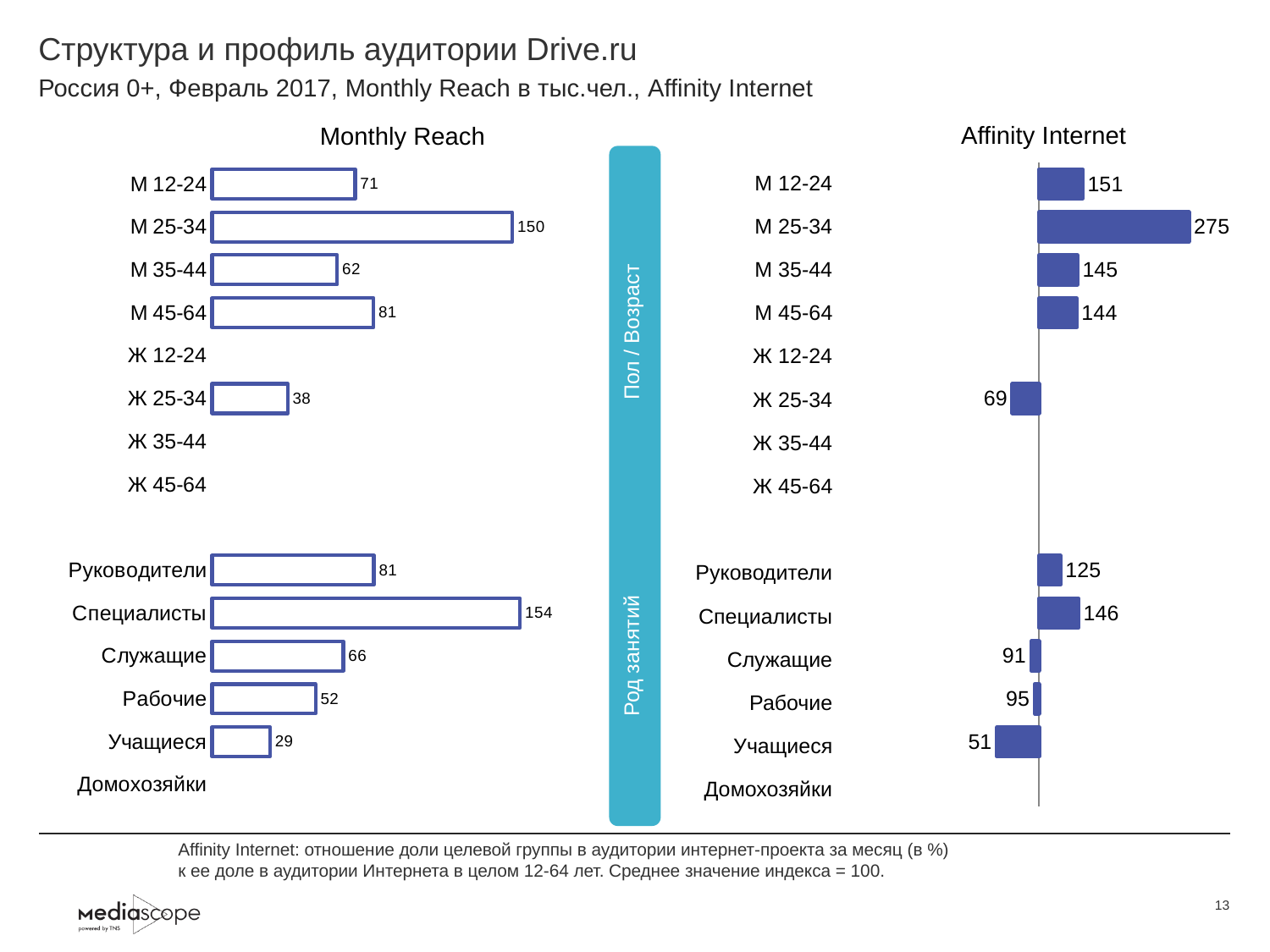
In the Monthly Reach chart, what is the value for М 25-34? 150 In the Affinity Internet chart, which labelled category has the lowest value? Учащиеся In the Monthly Reach chart, which category has the highest value? Специалисты In the Monthly Reach chart, which is larger: the value for Руководители or the value for Служащие? Руководители In the Affinity Internet chart, what is the value for Ж 25-34? 69 In the Affinity Internet chart, which category has the highest value? М 25-34 What type of chart is the Monthly Reach chart? Bar chart In the Affinity Internet chart, what is the difference between the values for Специалисты and Служащие? 55 In the Monthly Reach chart, what is the difference between the values for М 25-34 and М 35-44? 88 In the Affinity Internet chart, which is larger: the value for Рабочие or the value for Учащиеся? Рабочие In the Affinity Internet chart, what is the value for Руководители? 125 In the Monthly Reach chart, what is the value for Учащиеся? 29